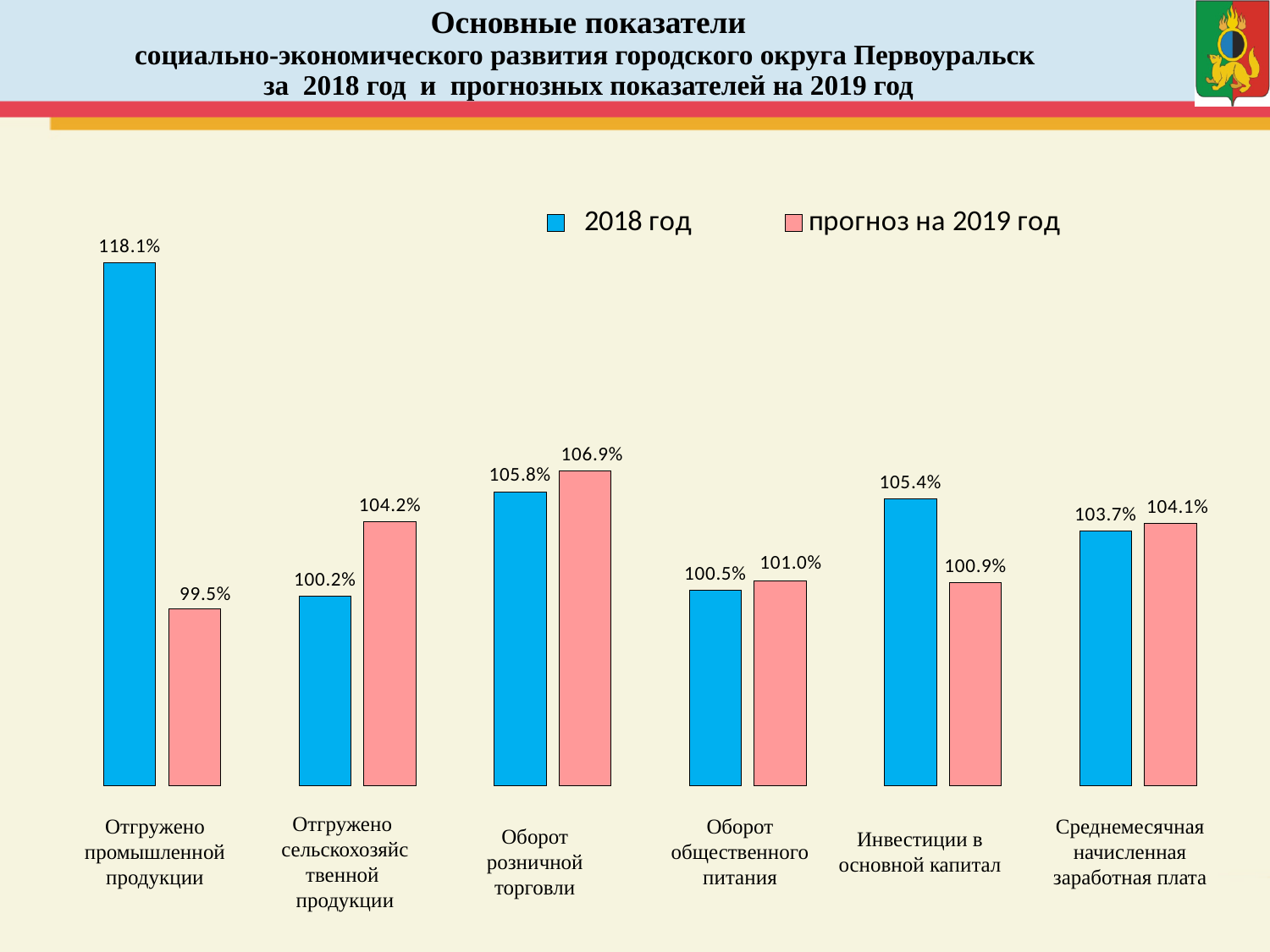
How many categories are shown on the x axis? 6 What is the прогноз на 2019 год value for Оборот розничной торговли? 106.9% What is the difference between the 2018 год and прогноз на 2019 год values for Отгружено промышленной продукции? 18.6 percentage points What is the 2018 год value for Инвестиции в основной капитал? 105.4% What is the прогноз на 2019 год value for Среднемесячная начисленная заработная плата? 104.1% For Инвестиции в основной капитал, which is larger: the 2018 год value or the прогноз на 2019 год value? 2018 год Which category has the lowest прогноз на 2019 год value? Отгружено промышленной продукции How many series does the legend list? 2 What colour are the bars for the прогноз на 2019 год series? Pink What type of chart is shown on the slide? Bar chart Which category has the highest 2018 год value? Отгружено промышленной продукции What is the 2018 год value for Отгружено промышленной продукции? 118.1%